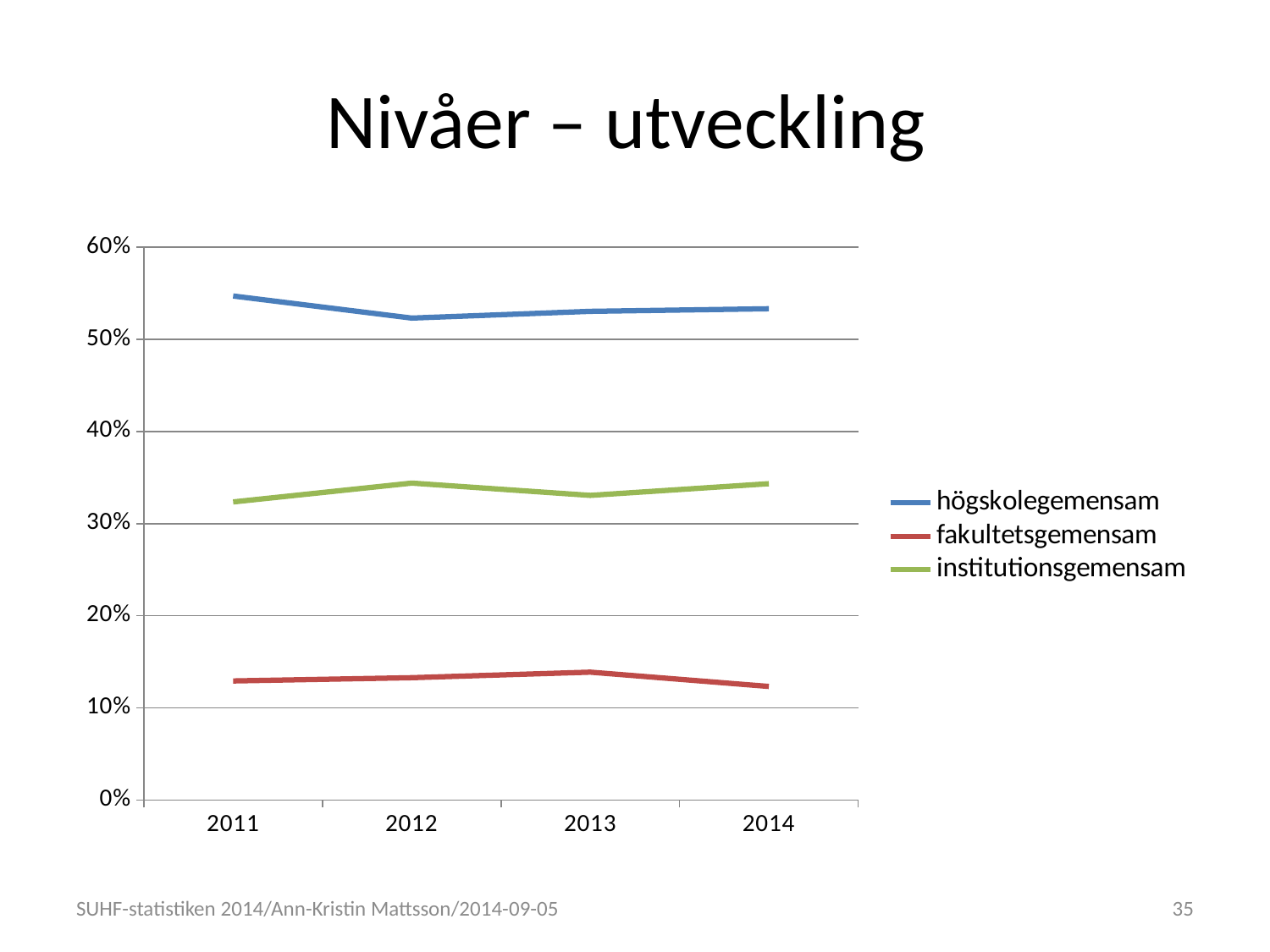
How many years are shown on the x axis? 4 Which series has the highest values across all years? högskolegemensam Is the value for fakultetsgemensam in 2014 greater or less than 20%? less Is the value for institutionsgemensam in 2012 greater or less than 30%? greater What is the title of the chart's slide? Nivåer – utveckling Which series has the lowest values across all years? fakultetsgemensam In 2014, which is larger: the value for institutionsgemensam or the value for fakultetsgemensam? institutionsgemensam Is the value for institutionsgemensam in 2013 greater or less than 40%? less Which colour is used for the fakultetsgemensam line? red How many series does the legend list? 3 What kind of chart is shown on the slide? line chart